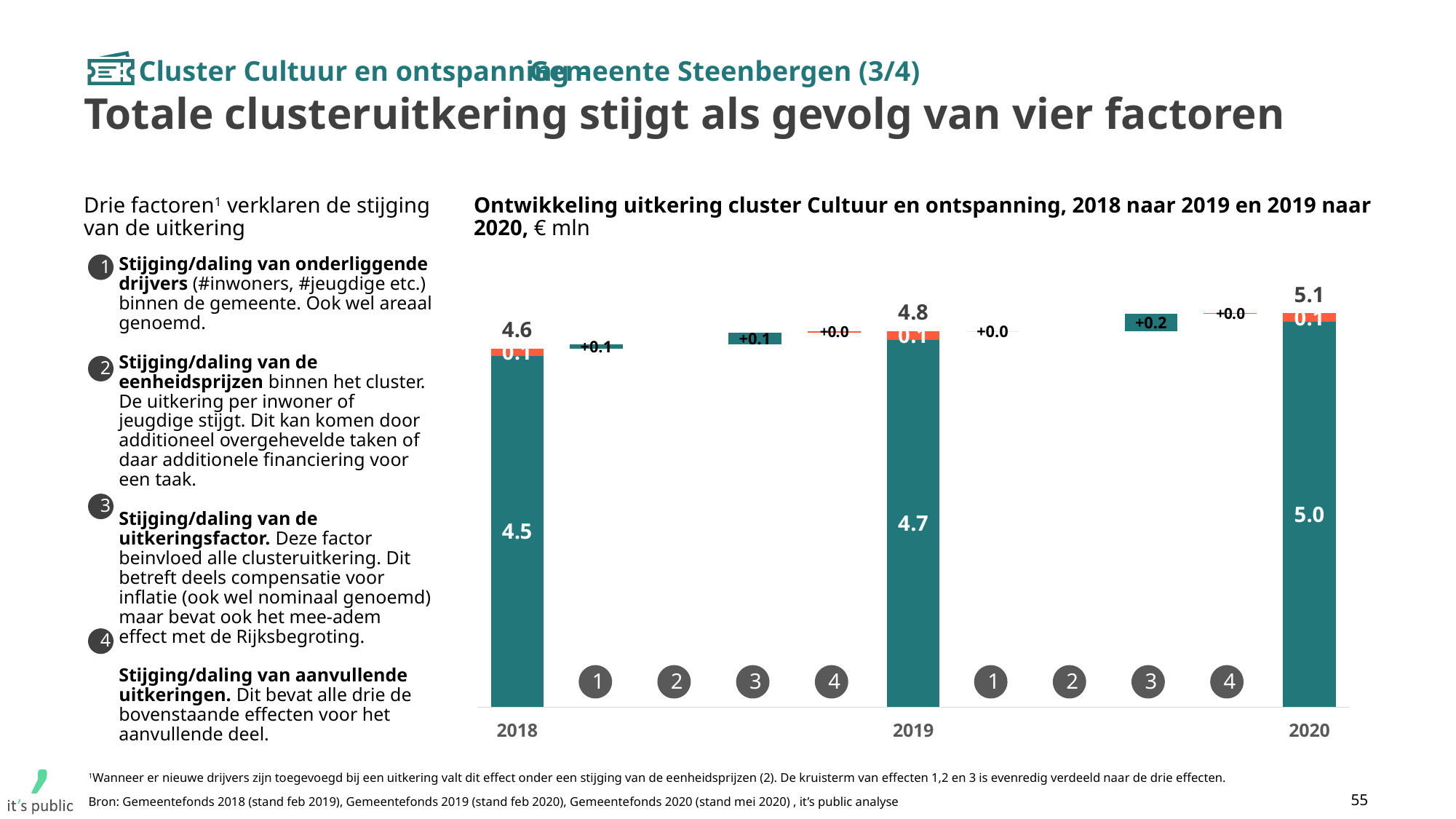
What is the effect of factor 1 between 2018 and 2019? +0.1 Which is larger, the total for 2019 or the total for 2018? 2019 Do the year totals rise or fall from 2018 to 2020? rise What is the effect of factor 4 between 2019 and 2020? +0.0 Which year has the highest total uitkering? 2020 What is the total uitkering for 2020 shown above the bar? 5.1 What is the value of the large teal segment of the 2019 bar? 4.7 What is the effect of factor 3 between 2019 and 2020? +0.2 In what unit are the values in the chart expressed? € mln What is the total uitkering for 2018 shown above the bar? 4.6 What is the value of the small orange segment on top of the 2018 bar? 0.1 What is the difference between the total for 2020 and the total for 2018? 0.5